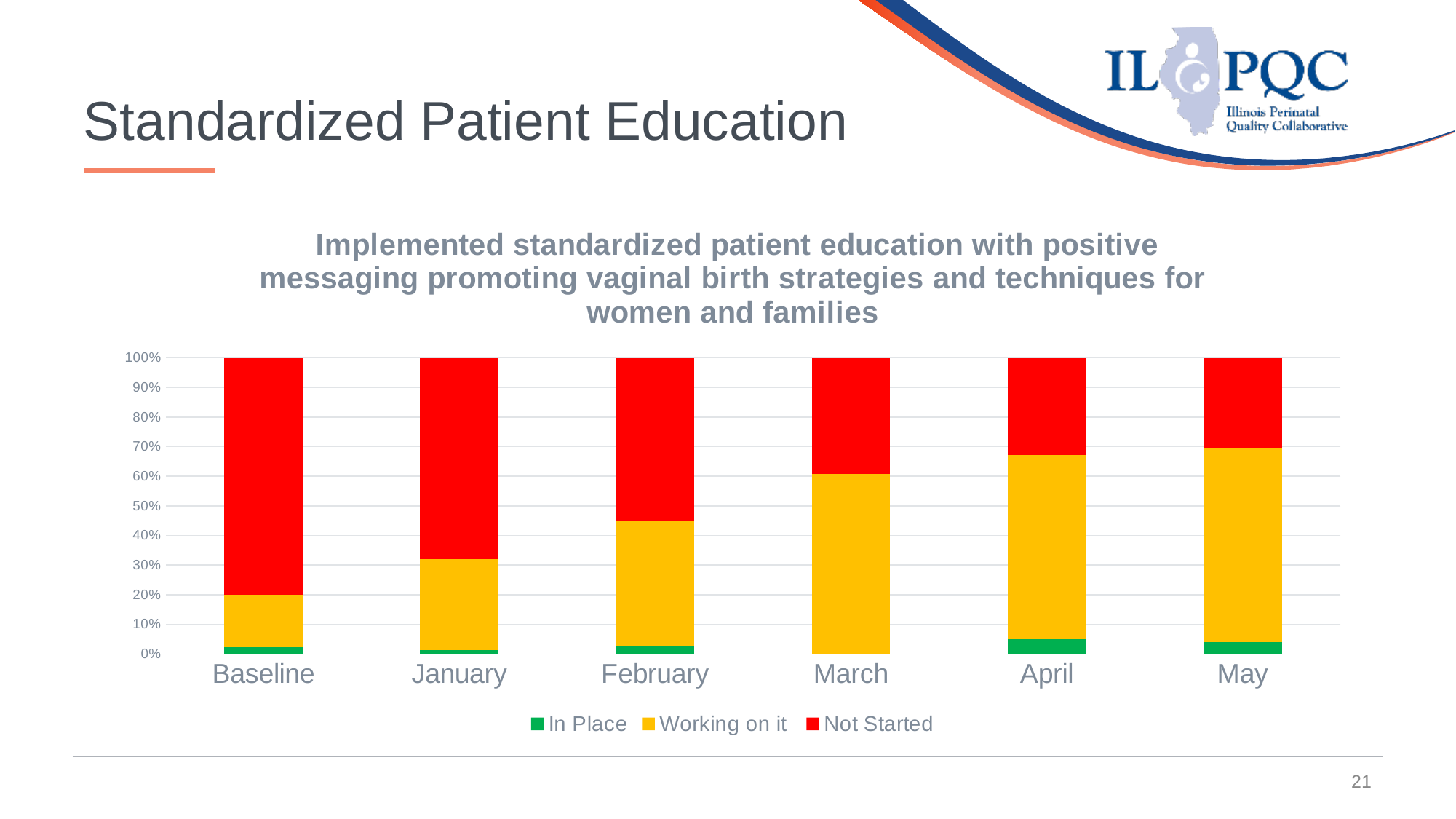
Is the Not Started value for Baseline greater or less than 70%? greater Is the Working on it value for March greater or less than 50%? greater How many series does the chart legend list? 3 Which category has the largest Not Started share? Baseline How many categories are shown along the x axis of the chart? 6 Which series is shown in red in the chart? Not Started Which is larger, the Not Started share for January or for March? January What kind of chart is shown on the slide? Stacked bar chart Is the Not Started value for May greater or less than 40%? less Does the Not Started share rise or fall from Baseline to May? Fall What is the total of the stacked bar for March? 100%